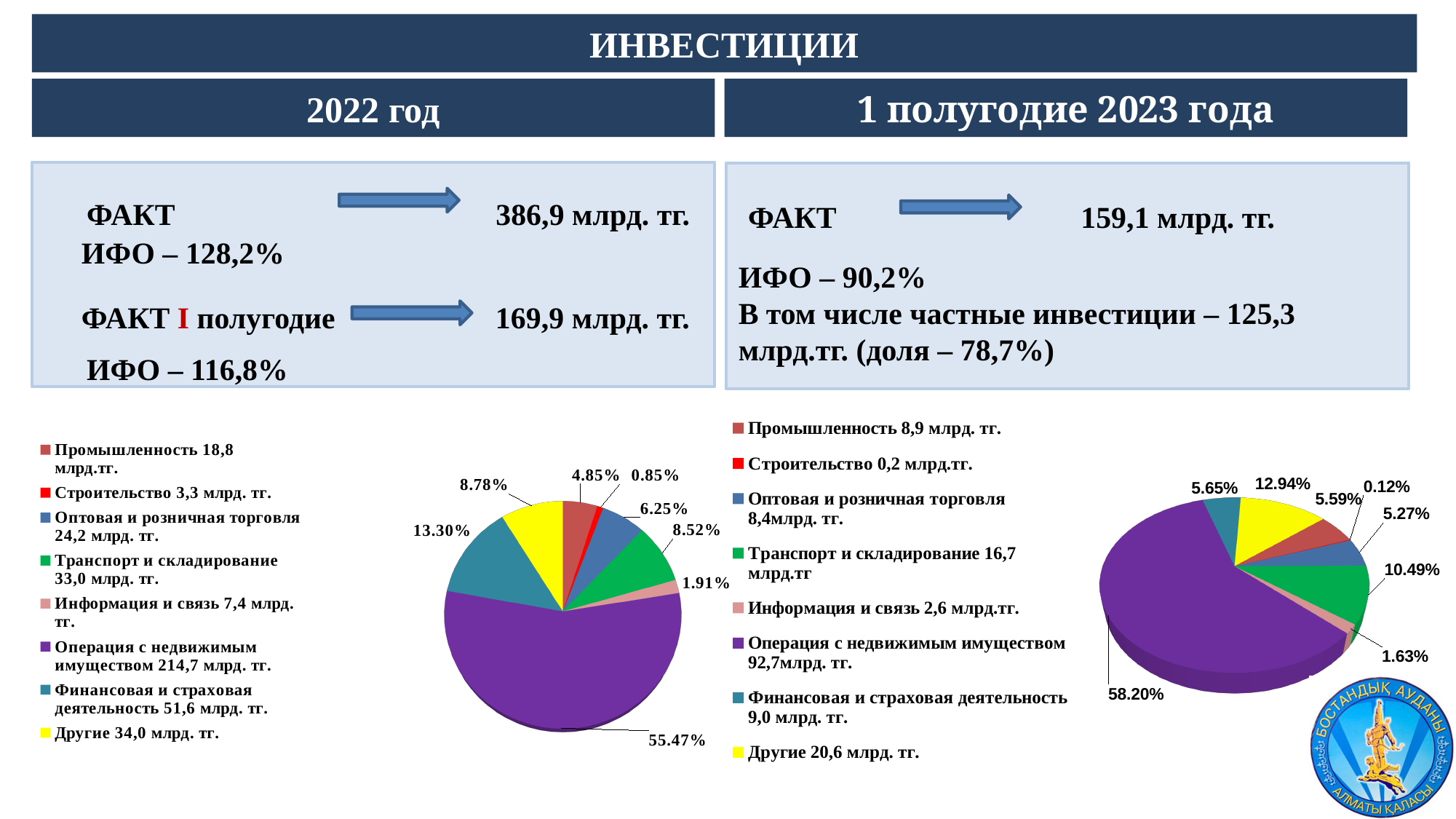
How many categories does the legend of the 2022 год pie chart list? 8 On the 1 полугодие 2023 года pie chart, what share does Другие have? 12.94% According to the legend of the 2022 год pie chart, what is the value for Транспорт и складирование? 33,0 млрд. тг. On the 2022 год pie chart, which category has the smallest share? Строительство On the 2022 год pie chart, what is the difference between the shares of Транспорт и складирование and Оптовая и розничная торговля? 2.27% On the 2022 год pie chart, what share does Финансовая и страховая деятельность have? 13.30% On the 1 полугодие 2023 года pie chart, what share does Транспорт и складирование have? 10.49% On the 1 полугодие 2023 года pie chart, what colour is the Операция с недвижимым имуществом slice? Purple What type of chart is used for the 1 полугодие 2023 года data? Pie chart On the 1 полугодие 2023 года pie chart, which is larger: the share of Другие or the share of Транспорт и складирование? Другие On the 1 полугодие 2023 года pie chart, which category has the largest share? Операция с недвижимым имуществом On the 2022 год pie chart, what share does Операция с недвижимым имуществом have? 55.47%